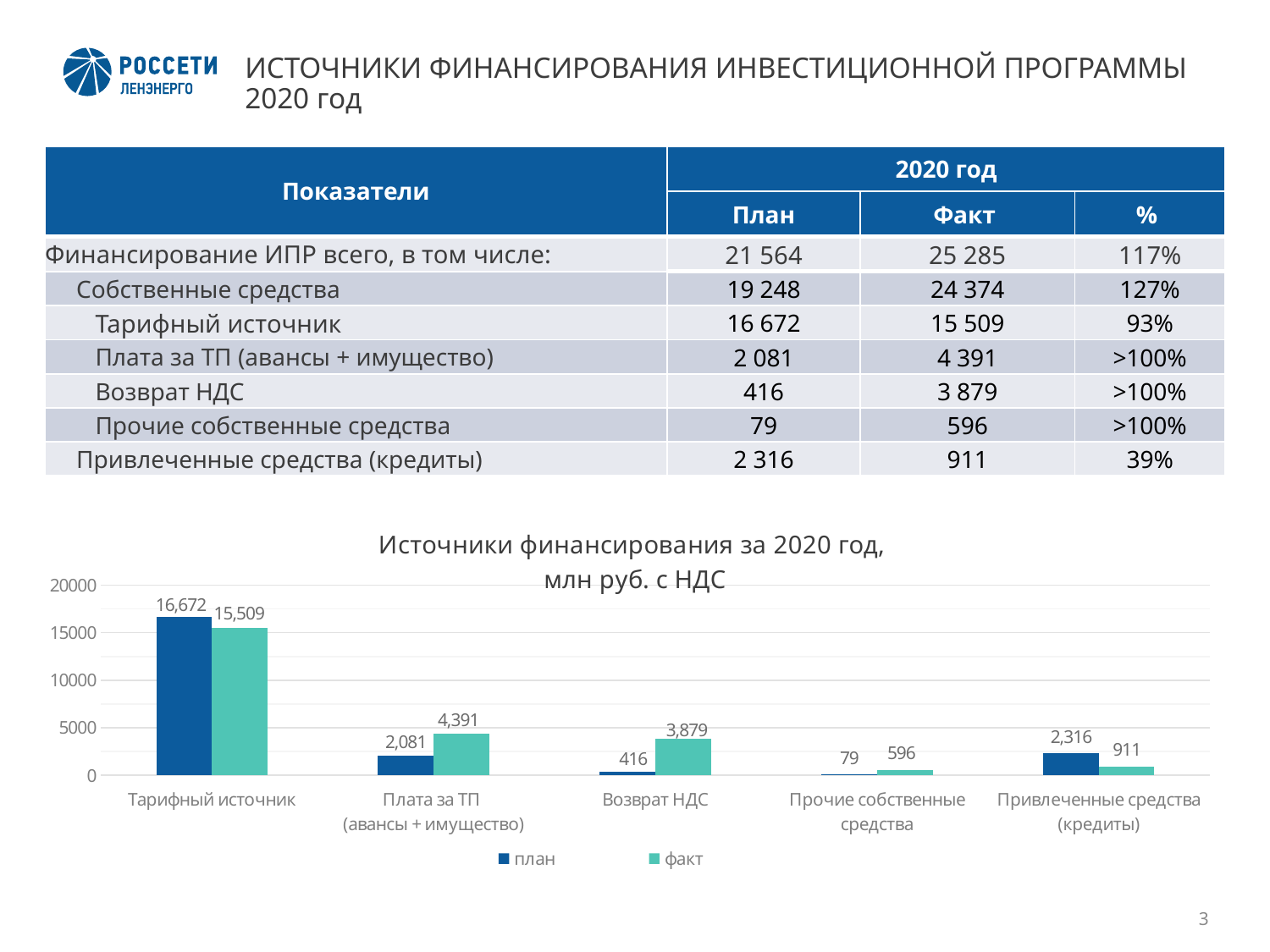
What is the факт value for Привлеченные средства (кредиты)? 911 What is the план value for Тарифный источник? 16,672 Which is larger for Привлеченные средства (кредиты): план or факт? план Which category has the lowest план value? Прочие собственные средства What is the план value for Прочие собственные средства? 79 What is the факт value for Возврат НДС? 3,879 What is the difference between the план and факт values for Плата за ТП (авансы + имущество)? 2,310 How many categories are shown on the x axis? 5 How many series does the legend list? 2 What type of chart is shown on the slide? bar chart Which category has the highest факт value? Тарифный источник What is the title of the chart? Источники финансирования за 2020 год, млн руб. с НДС